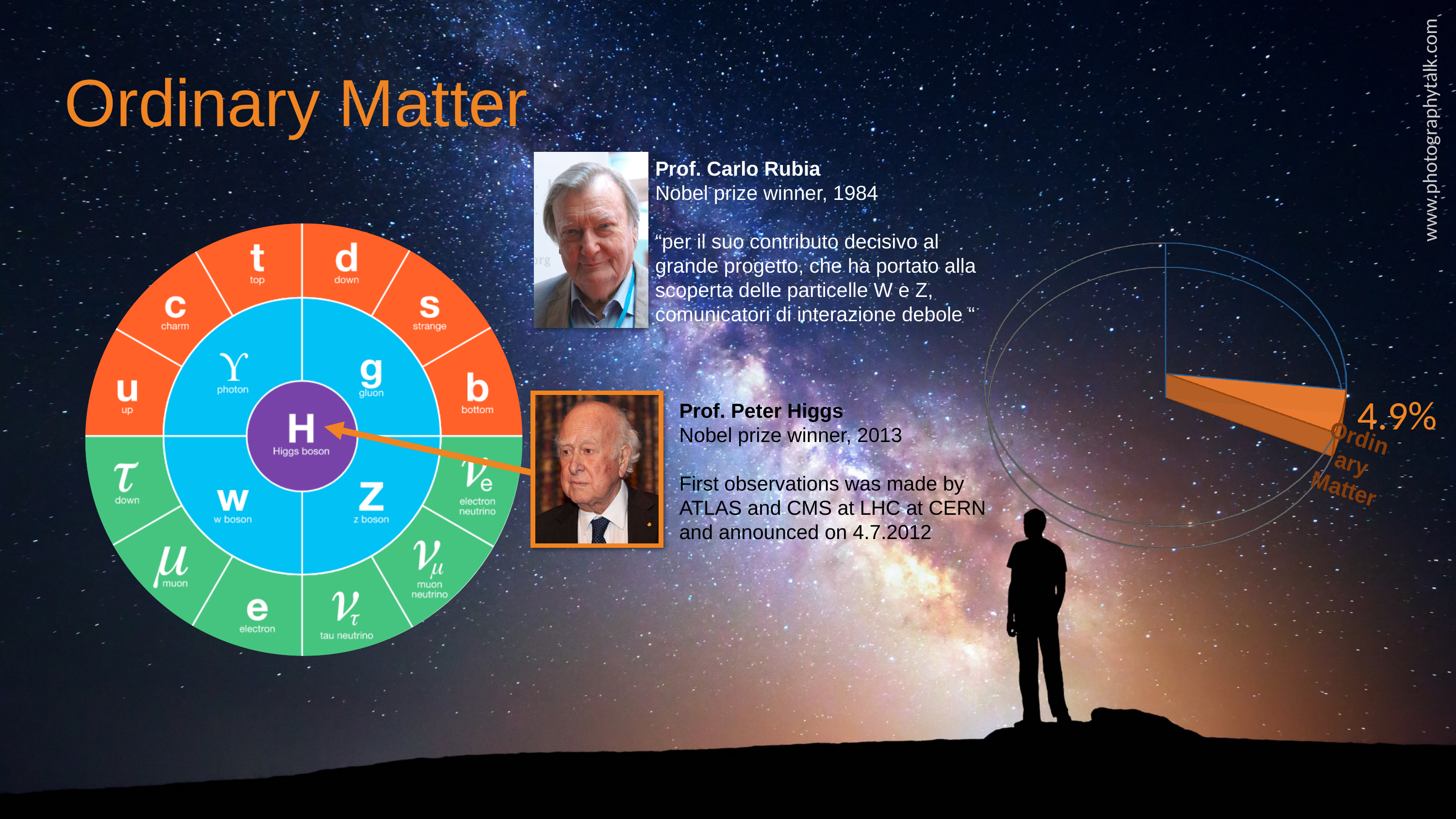
What kind of chart is shown on the right side of the slide? pie chart In the pie chart on the right, what value is shown for the Ordinary Matter slice? 4.9% In the pie chart on the right, what colour is the Ordinary Matter slice? orange In the pie chart on the right, how many slices are labelled with a value? 1 In the pie chart on the right, what is the label of the slice marked 4.9%? Ordinary Matter In the pie chart on the right, what share of the pie does the Ordinary Matter slice represent? 4.9%